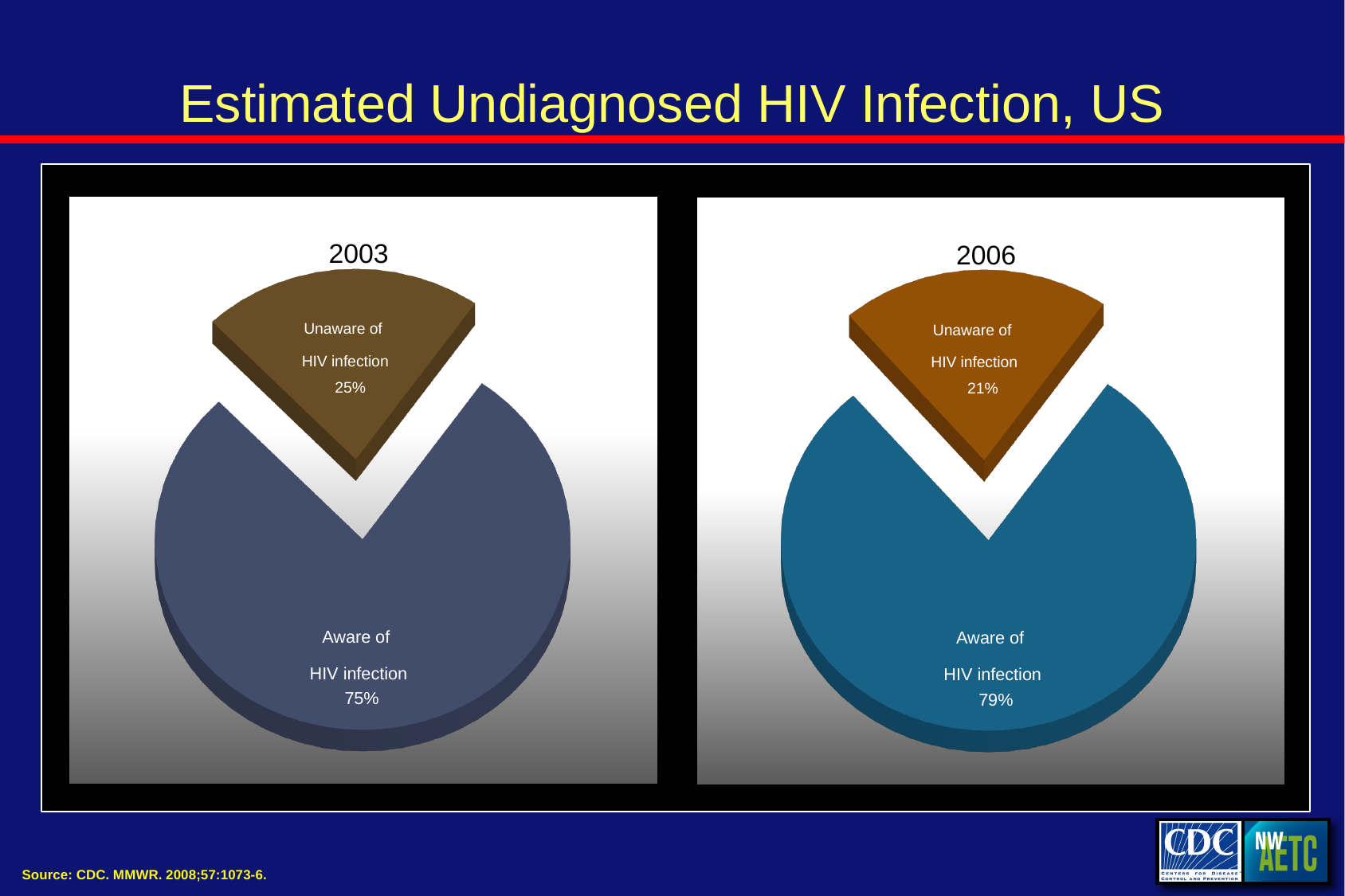
In the 2006 pie chart, which slice is the largest? Aware of HIV infection How many slices does the 2006 pie chart have? 2 In the 2003 pie chart, what colour is the 'Unaware of HIV infection' slice? Brown In the 2003 pie chart, what percentage were aware of HIV infection? 75% What is the difference between the 'Aware of HIV infection' and 'Unaware of HIV infection' shares in the 2003 pie chart? 50% In the 2006 pie chart, what percentage were unaware of HIV infection? 21% In the 2003 pie chart, which slice is the smallest? Unaware of HIV infection In the 2006 pie chart, what percentage were aware of HIV infection? 79% Which year's pie chart shows a larger 'Unaware of HIV infection' share, 2003 or 2006? 2003 What is the title of the slide containing the two pie charts? Estimated Undiagnosed HIV Infection, US In the 2003 pie chart, what percentage were unaware of HIV infection? 25% What type of chart is used on the left side of the slide for 2003? Pie chart